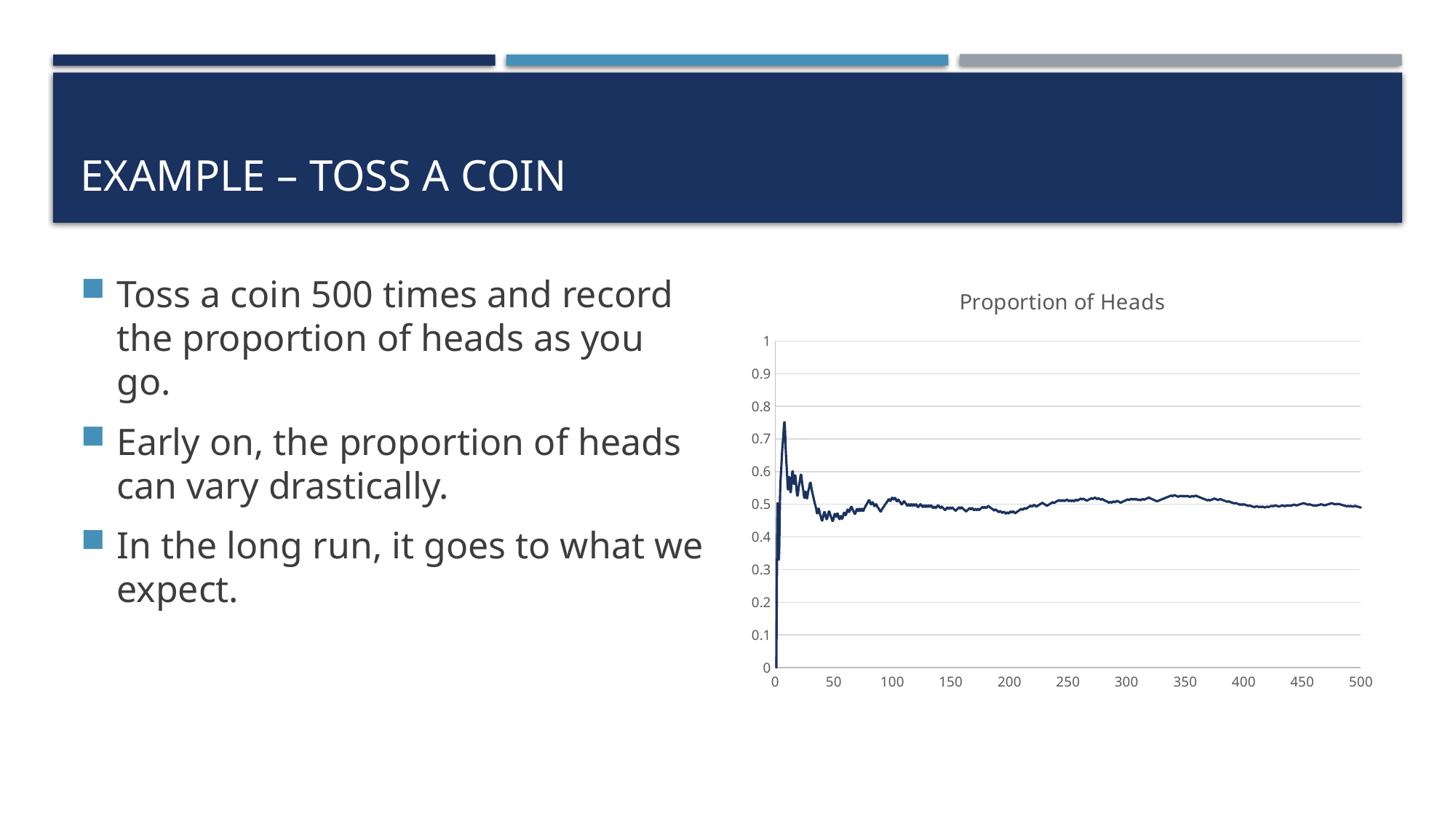
Is the proportion of heads at 300 tosses greater or less than 0.4? greater Is the proportion of heads at 100 tosses greater or less than 0.7? less Is the proportion of heads at 500 tosses greater or less than 0.4? greater Does the line fluctuate more at the start or at the end of the x axis? at the start What is the highest value shown on the chart's x axis? 500 What is the title of the chart? Proportion of Heads What kind of chart is shown on the slide? line chart